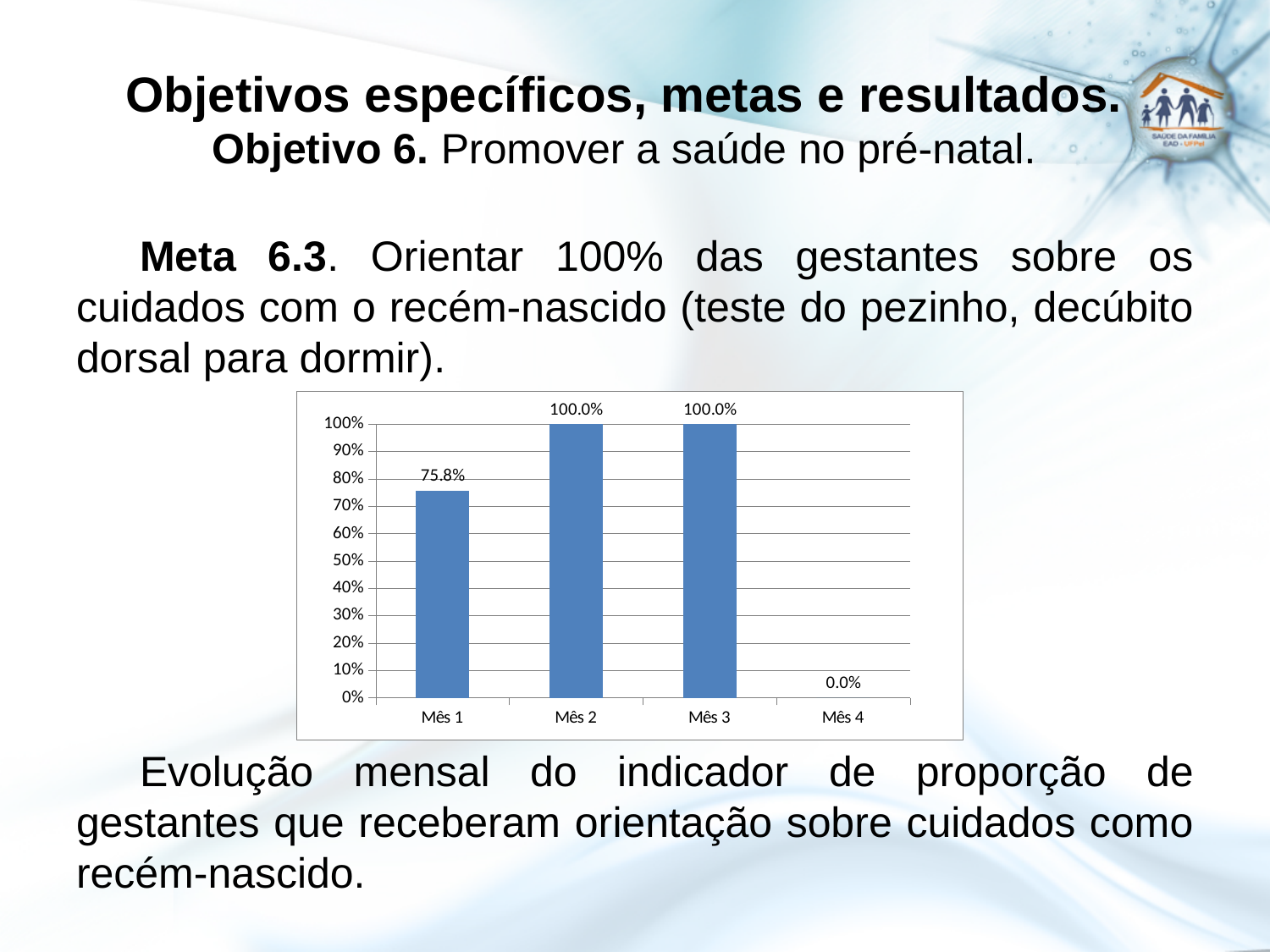
What is the value for Mês 1? 75.8% What is the value for Mês 4? 0.0% What is the highest tick shown on the y axis? 100% What is the value for Mês 2? 100.0% Does the value rise or fall from Mês 1 to Mês 2? rise Is the value for Mês 1 greater or less than 70%? greater How many months have a value of 100.0%? 2 How many months are shown on the x axis? 4 What is the difference between the values for Mês 2 and Mês 1? 24.2% Which is larger, the value for Mês 1 or the value for Mês 3? Mês 3 Which month has the lowest value? Mês 4 What kind of chart is shown on the slide? bar chart